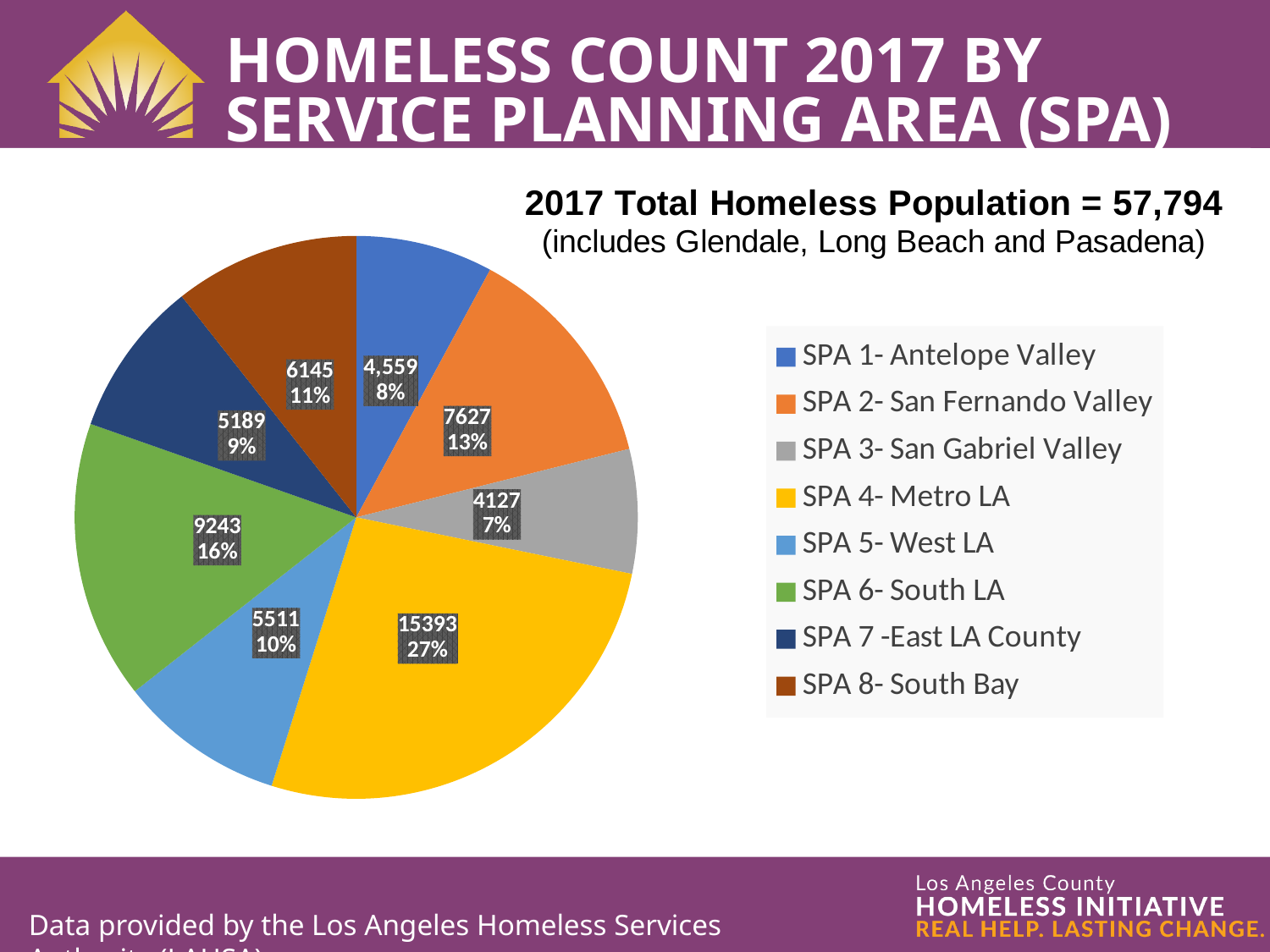
Which SPA has the largest homeless count? SPA 4- Metro LA How many slices does the pie chart have? 8 What percentage share of the pie does SPA 8- South Bay have? 11% What is the homeless count for SPA 6- South LA? 9243 What total homeless population is stated on the slide for 2017? 57,794 Which has a larger homeless count, SPA 5- West LA or SPA 7 -East LA County? SPA 5- West LA What type of chart is shown on the slide? pie chart What is the homeless count for SPA 1- Antelope Valley? 4,559 Which SPA has the smallest homeless count? SPA 3- San Gabriel Valley What percentage share of the pie does SPA 2- San Fernando Valley have? 13% What is the homeless count for SPA 4- Metro LA? 15393 What is the difference between the homeless counts for SPA 4- Metro LA and SPA 6- South LA? 6150